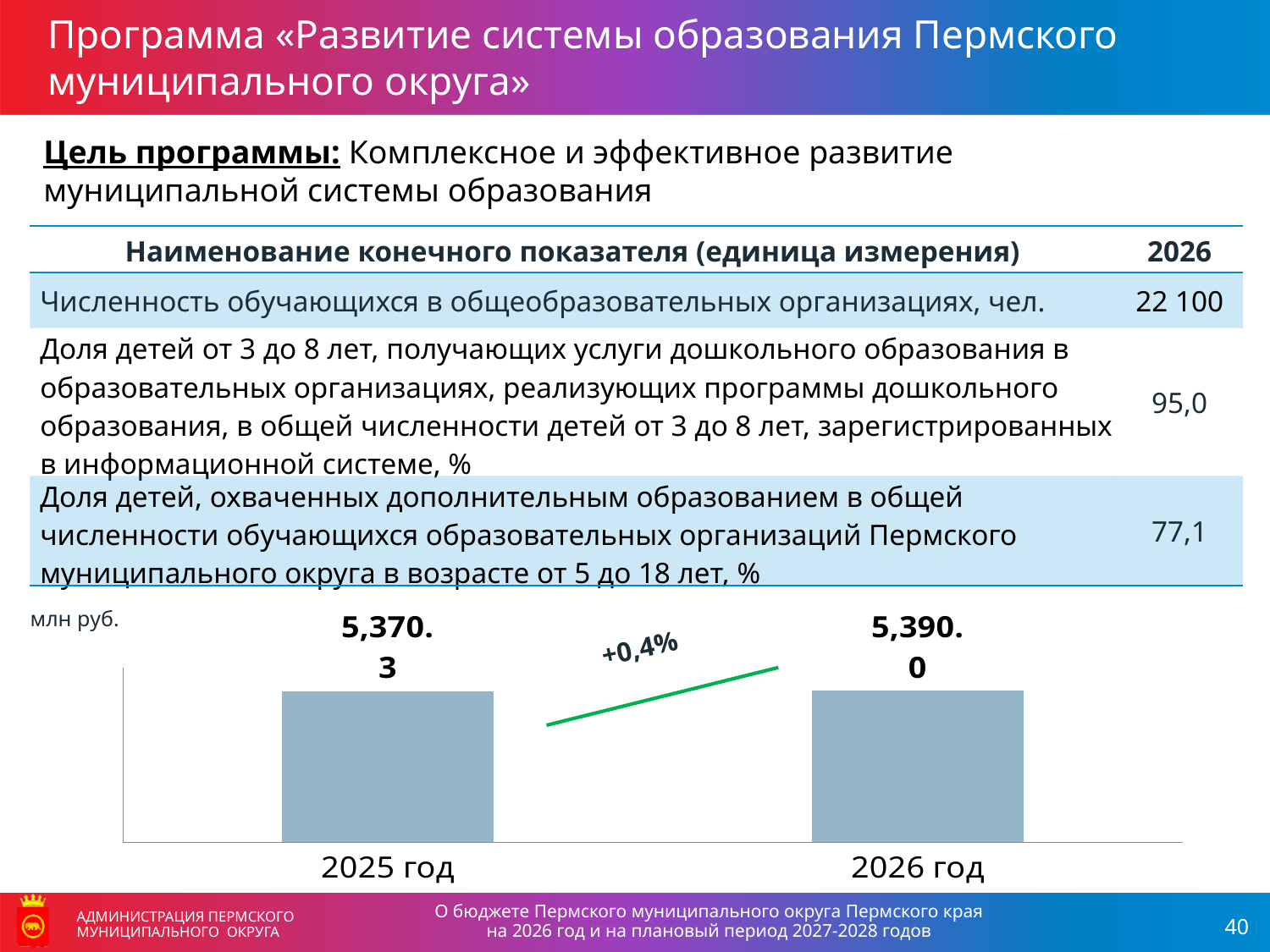
How many bars does the chart at the bottom of the slide have? 2 What unit of measurement is shown for the bar chart? млн руб. What kind of chart is shown at the bottom of the slide? bar chart Which category has the lowest value in the bar chart? 2025 год What is the difference between the 2026 год and 2025 год values in the bar chart? 19.7 Do the values in the bar chart rise or fall from 2025 год to 2026 год? rise What is the value for 2025 год in the bar chart? 5,370.3 What percentage change is annotated between the two bars in the chart? +0,4% What is the value for 2026 год in the bar chart? 5,390.0 Which year has the higher value in the bar chart, 2025 год or 2026 год? 2026 год Which category has the highest value in the bar chart? 2026 год